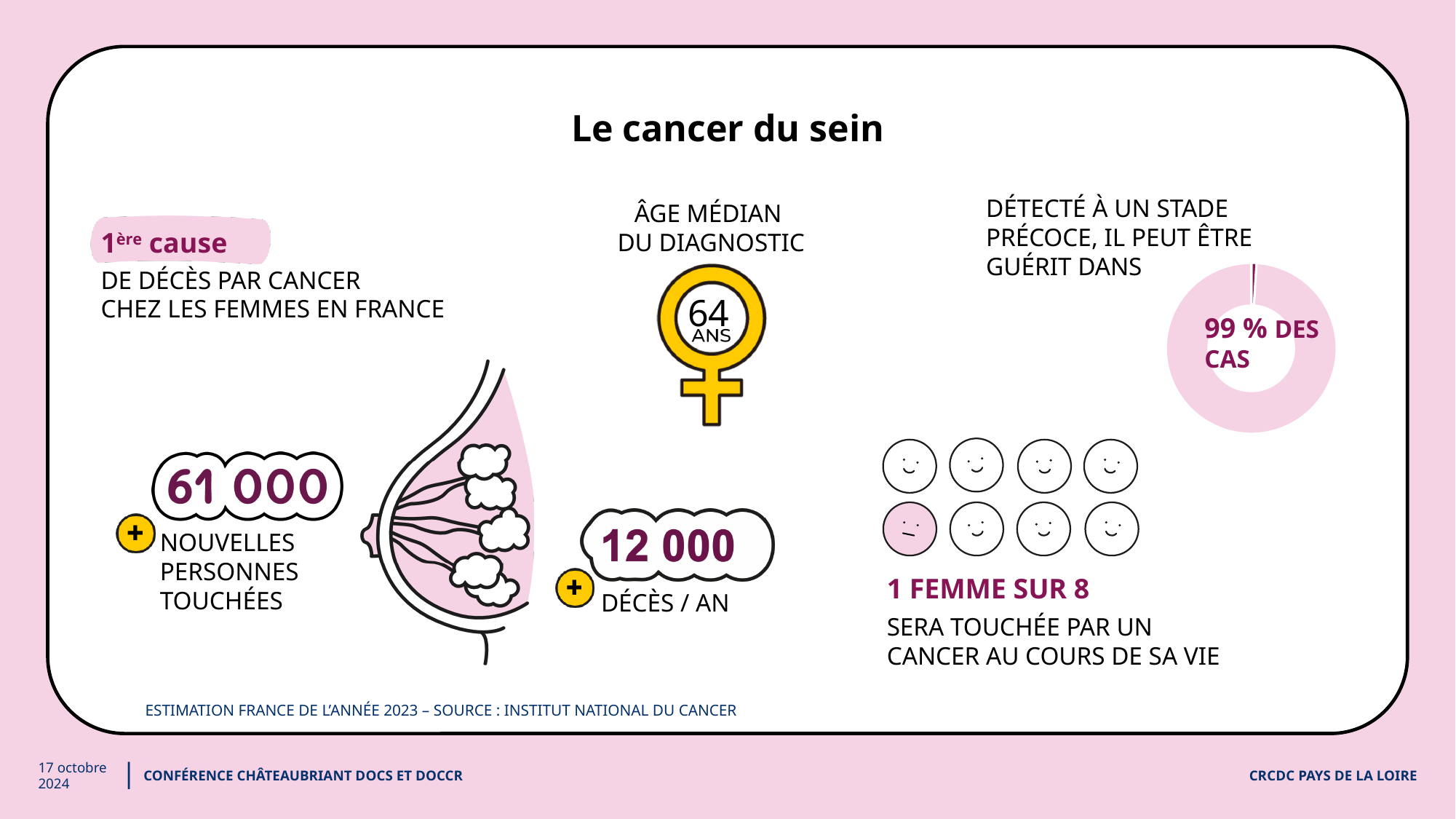
Is the pink portion of the donut chart greater or less than 50%? greater What is the median age at diagnosis shown in the female symbol icon? 64 ans What label is printed inside the donut chart? 99 % DES CAS How many new people affected are shown in the left cloud figure? 61 000 According to the pictogram, how many women out of 8 will be affected by cancer during their life? 1 What is the difference between the number of new people affected and the number of deaths per year? 49 000 Which figure is larger: the number of new people affected or the number of deaths per year? new people affected (61 000) How many deaths per year are shown in the cloud figure in the middle of the slide? 12 000 What share of cases does the pink portion of the donut chart represent? 99 % How many face icons are shown in the pictogram grid on the right of the slide? 8 How many of the face icons in the pictogram grid are shaded pink? 1 What kind of chart is shown at the right of the slide next to the text 'GUÉRIT DANS'? donut chart